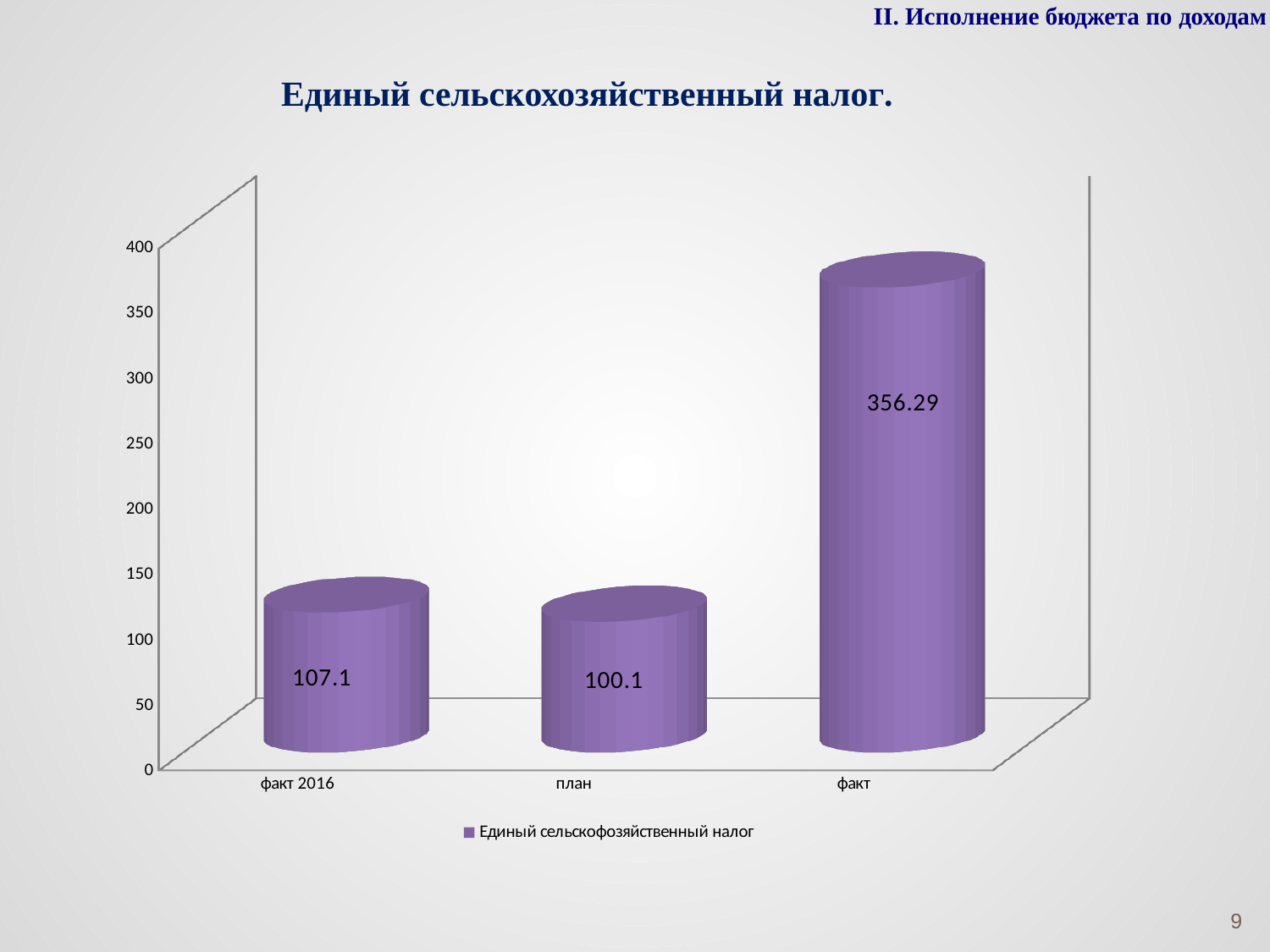
Which is larger, the value for факт or the value for факт 2016? факт What is the difference between the values for факт 2016 and план? 7 How many categories are shown on the x axis? 3 What kind of chart is shown on the slide? bar chart What is the value for факт? 356.29 Is the value for факт greater or less than 300? greater What is the value for факт 2016? 107.1 Which category has the highest value? факт Which category has the lowest value? план What is the value for план? 100.1 What is the difference between the values for факт and план? 256.19 What is the title of the chart? Единый сельскохозяйственный налог.